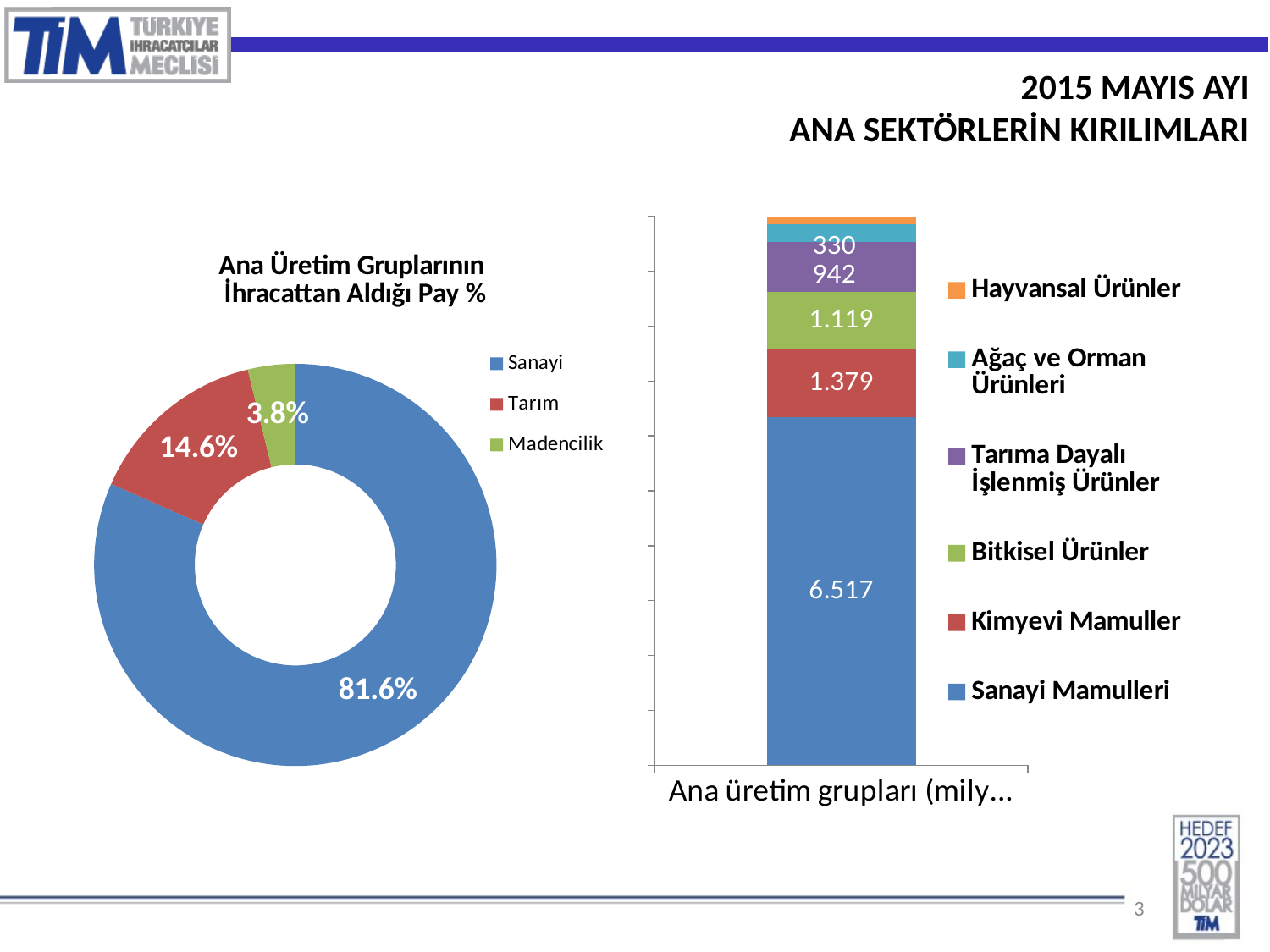
In the stacked bar chart on the right, what is the value for Sanayi Mamulleri? 6.517 In the doughnut chart on the left, what is the share for Madencilik? 3.8% In the doughnut chart on the left, which category has the smallest share? Madencilik In the doughnut chart on the left, how many percentage points larger is Tarım's share than Madencilik's? 10.8% How many categories does the legend of the doughnut chart on the left list? 3 What type of chart is the chart on the left of the slide? Doughnut (pie) chart In the stacked bar chart on the right, what is the value for Bitkisel Ürünler? 1.119 How many series does the legend of the stacked bar chart on the right list? 6 In the doughnut chart 'Ana Üretim Gruplarının İhracattan Aldığı Pay %', what share does Sanayi have? 81.6% In the doughnut chart on the left, what is the share for Tarım? 14.6% In the stacked bar chart on the right, which series has the largest segment? Sanayi Mamulleri In the stacked bar chart on the right, what is the value for Kimyevi Mamuller? 1.379